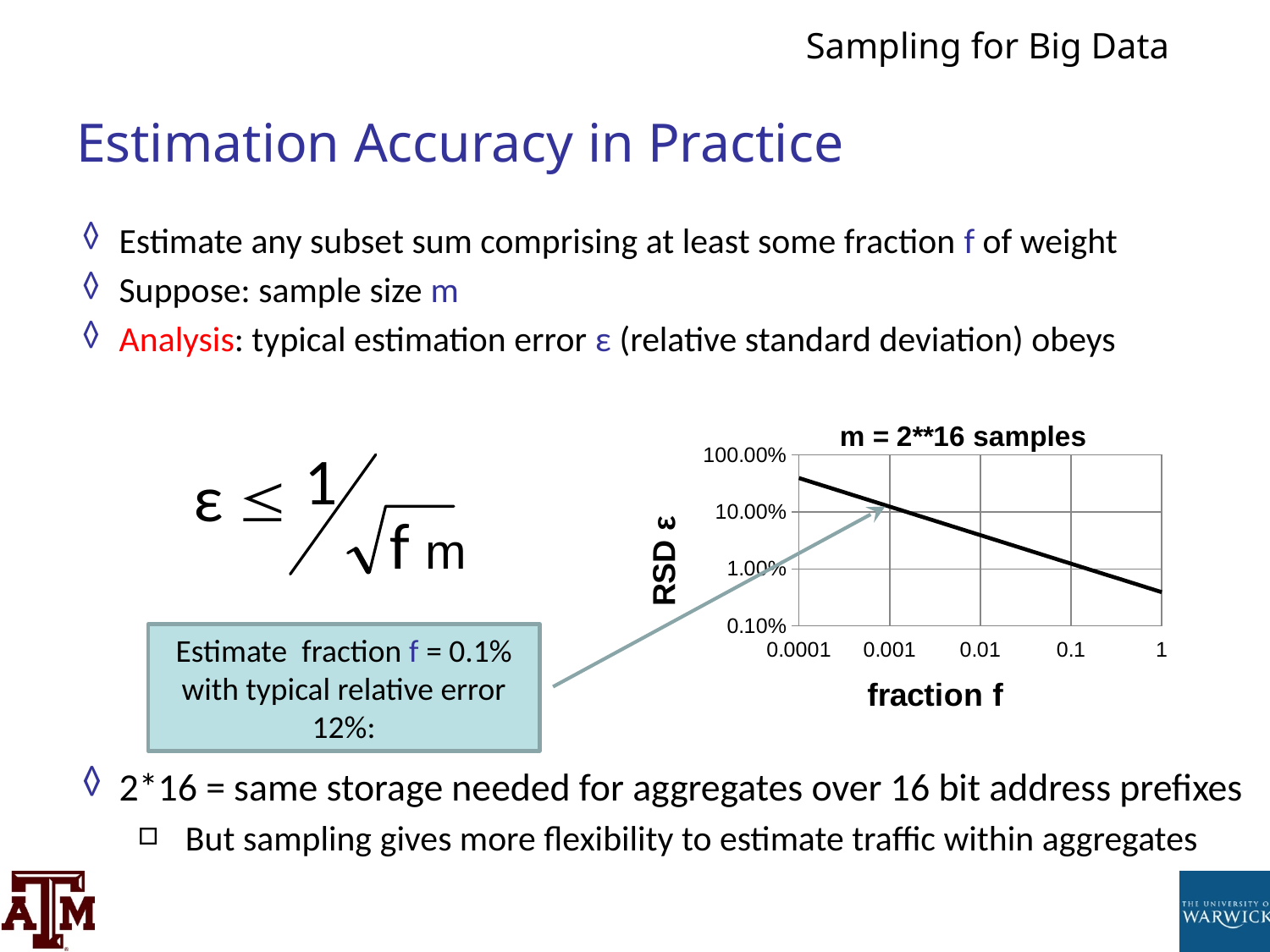
What is the title of the chart? m = 2**16 samples What kind of chart is shown on the slide? line chart Is the RSD ε value at fraction f = 0.0001 greater or less than 10.00%? greater Does the RSD ε value rise or fall as fraction f increases along the x axis? fall Is the RSD ε value at fraction f = 0.01 greater or less than 10.00%? less At which fraction f tick on the x axis is the RSD ε value highest? 0.0001 Which has the larger RSD ε value: fraction f = 0.0001 or fraction f = 1? 0.0001 How many tick values are labelled on the x axis of the chart? 5 Is the RSD ε value at fraction f = 1 greater or less than 1.00%? less What is the label of the x axis of the chart? fraction f